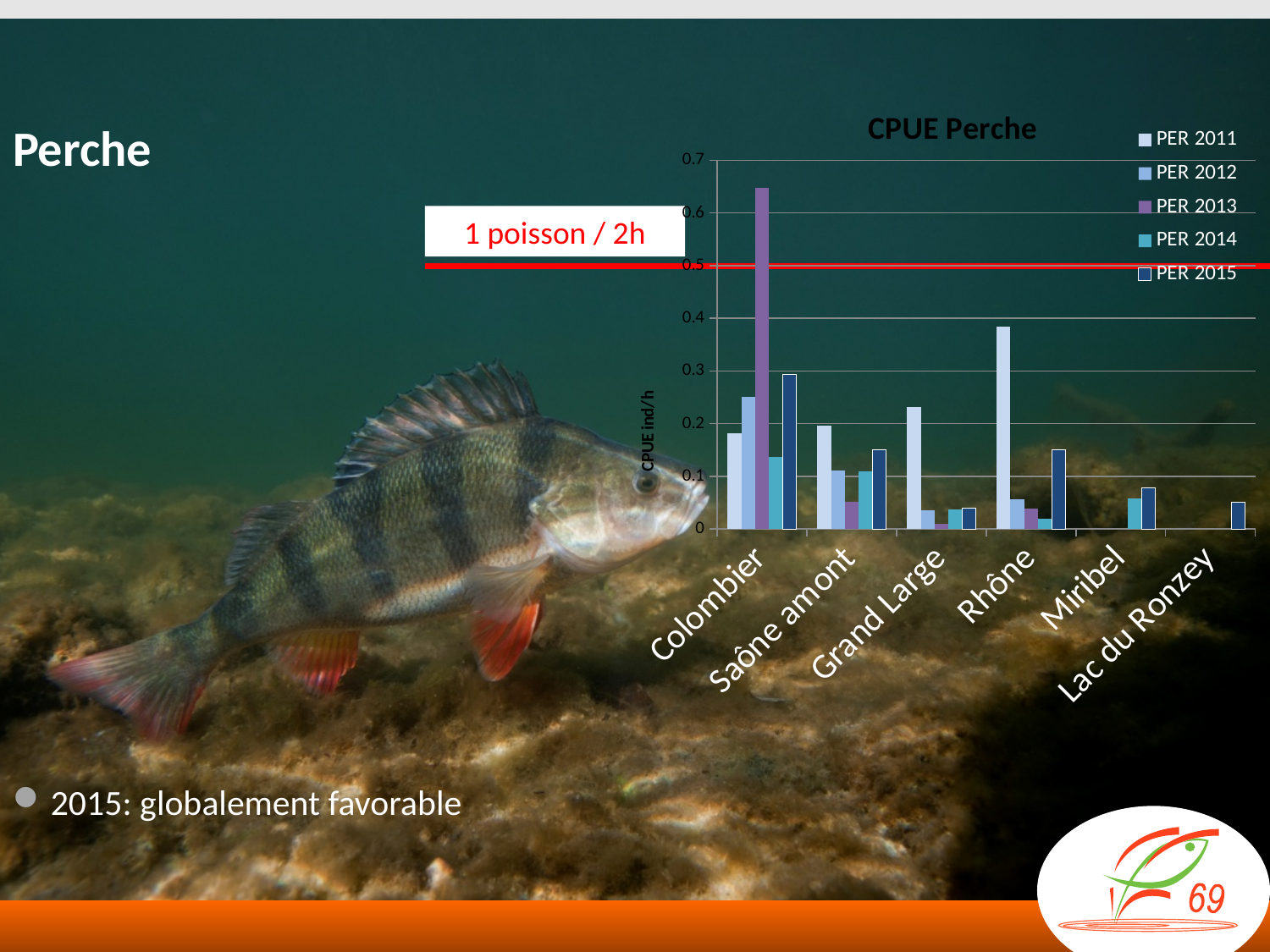
How many series does the chart legend list? 5 Is the PER 2015 value for Lac du Ronzey greater or less than 0.1? less Which category has the highest PER 2011 value? Rhône Which category has the highest PER 2015 value? Colombier Which is larger: the PER 2013 value for Colombier or the PER 2011 value for Rhône? PER 2013 value for Colombier What kind of chart is shown on the slide? bar chart Which category has the highest PER 2013 value? Colombier What is the title of the chart? CPUE Perche What is the label of the vertical axis? CPUE ind/h How many categories are shown on the x axis of the chart? 6 Is the PER 2011 value for Rhône greater or less than 0.3? greater Is the PER 2013 value for Colombier greater or less than 0.5? greater